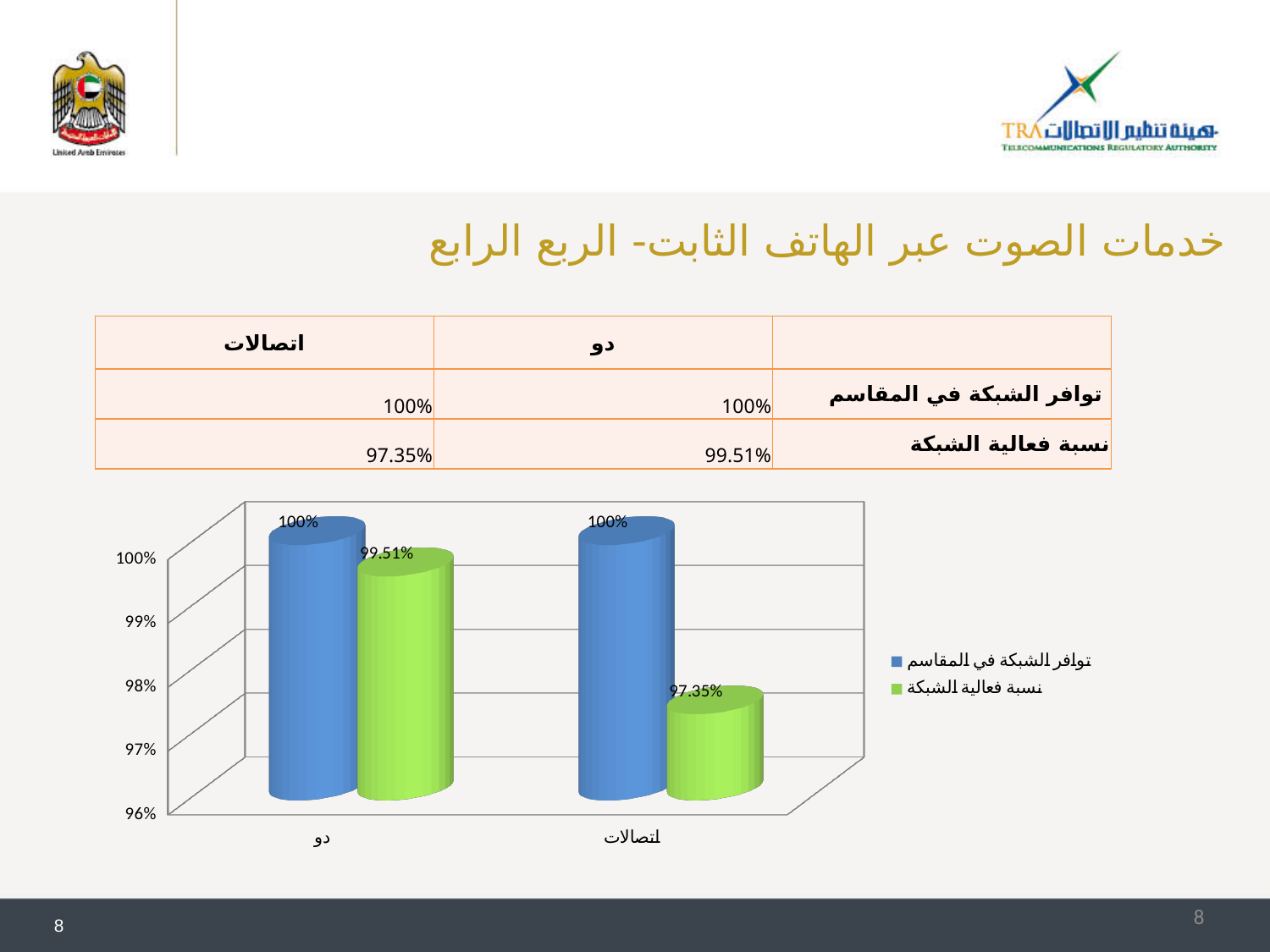
What is the value of توافر الشبكة في المقاسم for اتصالات in the chart? 100% What is the value of نسبة فعالية الشبكة for دو in the chart? 99.51% What colour represents the series نسبة فعالية الشبكة in the chart? green Which is larger: نسبة فعالية الشبكة for دو or for اتصالات? دو What is the value of نسبة فعالية الشبكة for اتصالات in the chart? 97.35% Which operator has the lower value for نسبة فعالية الشبكة? اتصالات What is the lowest value shown on the chart's vertical axis? 96% What is the difference between the نسبة فعالية الشبكة values for دو and اتصالات? 2.16% What type of chart is shown on the slide? bar chart How many categories (operators) are shown on the x axis of the chart? 2 How many series does the chart legend list? 2 Is the value of نسبة فعالية الشبكة for اتصالات greater or less than 98%? less